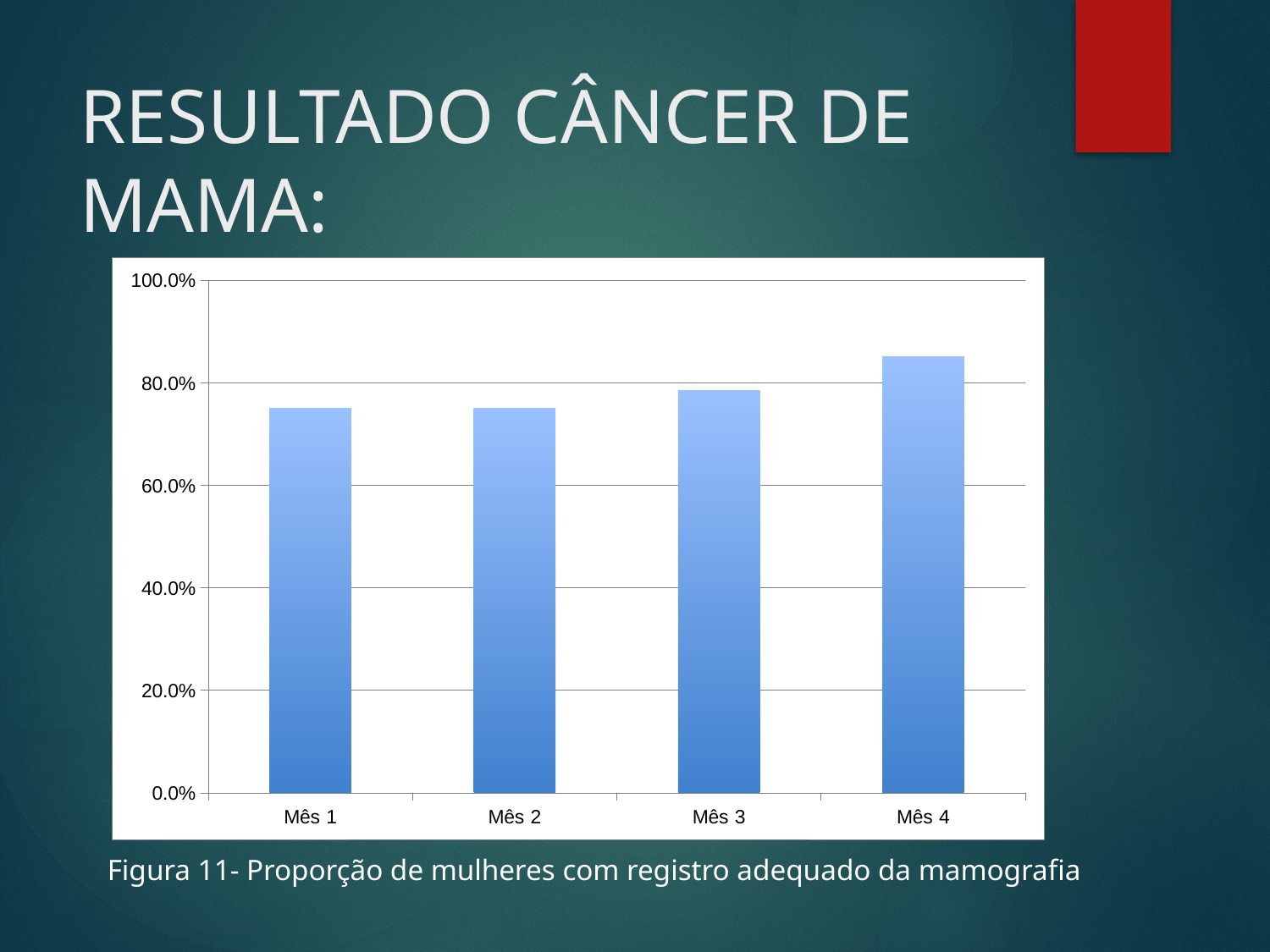
How many months (categories) are plotted on the chart? 4 Which is larger, the value for Mês 4 or the value for Mês 1? Mês 4 Which is larger, the value for Mês 3 or the value for Mês 2? Mês 3 What is the caption given below the chart? Figura 11- Proporção de mulheres com registro adequado da mamografia What is the maximum value shown on the vertical axis of the chart? 100.0% Do the values generally rise or fall from Mês 1 to Mês 4? Rise Is the value for Mês 4 greater or less than 80.0%? greater What kind of chart is shown on the slide? Bar chart Is the value for Mês 1 greater or less than 80.0%? less Is the value for Mês 2 greater or less than 60.0%? greater Which month has the highest value on the chart? Mês 4